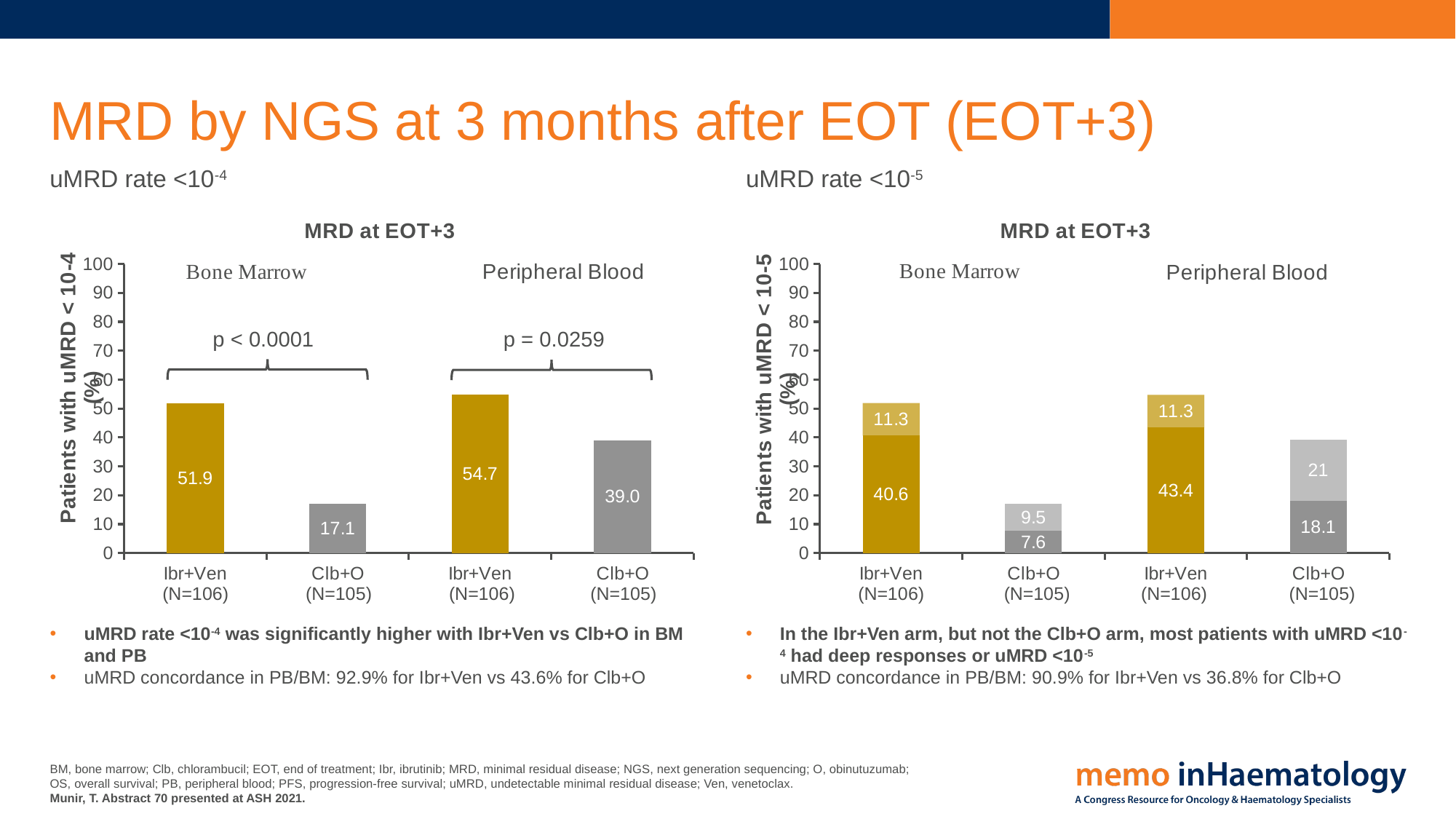
In the right chart (uMRD rate <10-5), which is larger: the lower segment for Ibr+Ven in Bone Marrow or the lower segment for Clb+O in Bone Marrow? Ibr+Ven in Bone Marrow In the left chart (uMRD rate <10-4), what is the value for Clb+O in Peripheral Blood? 39.0 In the left chart (uMRD rate <10-4), what is the value for Ibr+Ven in Bone Marrow? 51.9 What kind of chart is the left chart (uMRD rate <10-4)? Bar chart In the right chart (uMRD rate <10-5), what is the value of the lower (darker) segment for Ibr+Ven in Peripheral Blood? 43.4 In the right chart (uMRD rate <10-5), what is the value of the upper (lighter) segment for Clb+O in Bone Marrow? 9.5 In the left chart (uMRD rate <10-4), what is the difference between Ibr+Ven and Clb+O in Bone Marrow? 34.8 In the right chart (uMRD rate <10-5), what is the total of the stacked bar for Clb+O in Peripheral Blood? 39.1 In the left chart (uMRD rate <10-4), which bar is the lowest? Clb+O in Bone Marrow In the right chart (uMRD rate <10-5), what is the total of the stacked bar for Ibr+Ven in Bone Marrow? 51.9 In the left chart (uMRD rate <10-4), which bar is the highest? Ibr+Ven in Peripheral Blood In the left chart (uMRD rate <10-4), what p-value is shown for the Peripheral Blood comparison? p = 0.0259